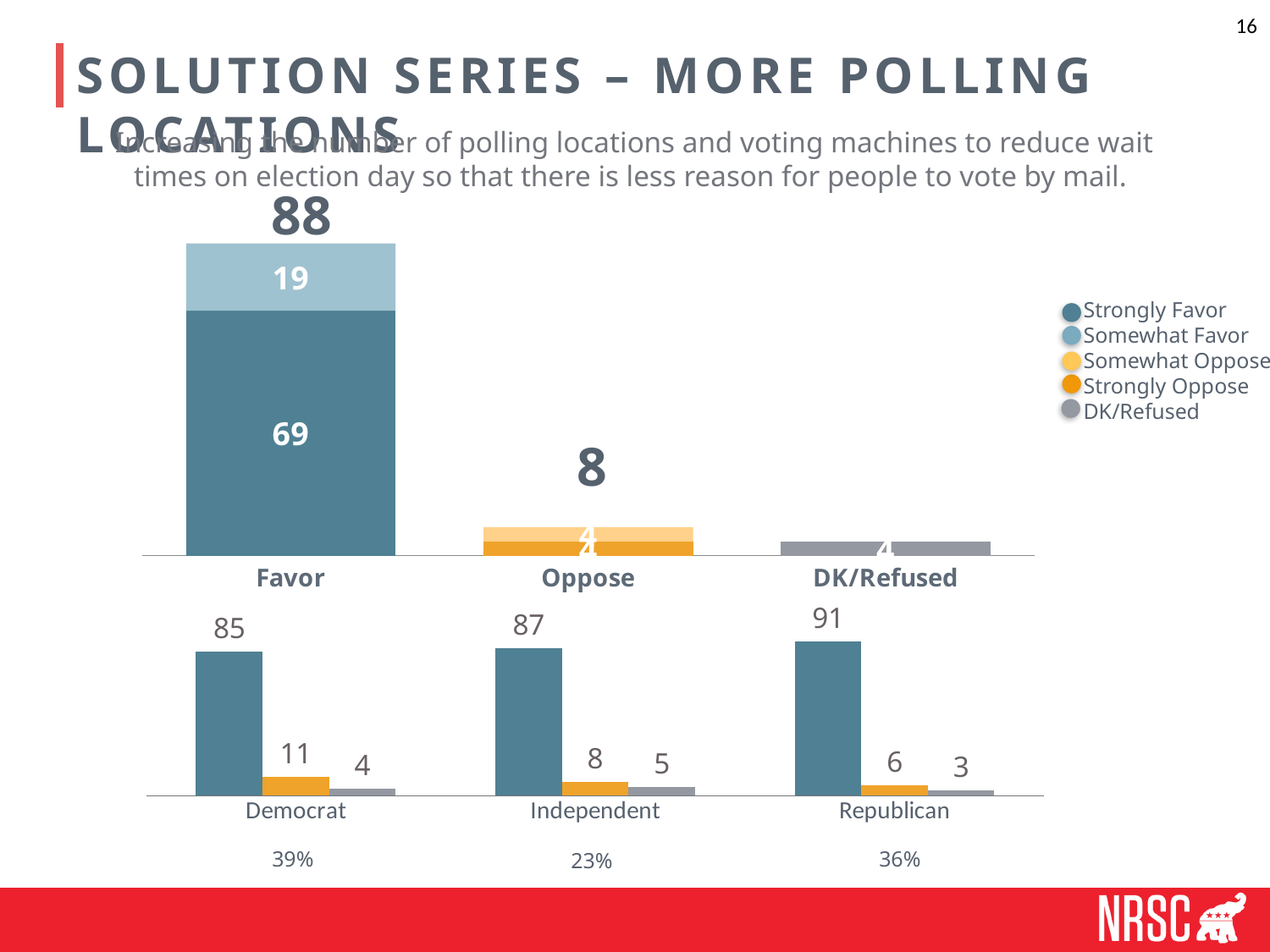
In the top chart, what is the value for DK/Refused? 4 In the bottom chart, what is the Favor value for Republican? 91 In the top chart, what is the Somewhat Favor value within the Favor bar? 19 In the top chart, what is the difference between the Favor total and the Oppose total? 80 In the top chart, what is the Strongly Favor value within the Favor bar? 69 How many entries does the legend of the top chart list? 5 In the bottom chart, what is the Oppose value for Democrat? 11 In the bottom chart, which party has the lowest DK/Refused value? Republican In the top chart, what is the total for the Oppose bar? 8 In the top chart, what is the total for the Favor bar? 88 In the bottom chart, which party has the highest Favor value? Republican In the bottom chart, what is the difference between the Favor values for Independent and Democrat? 2